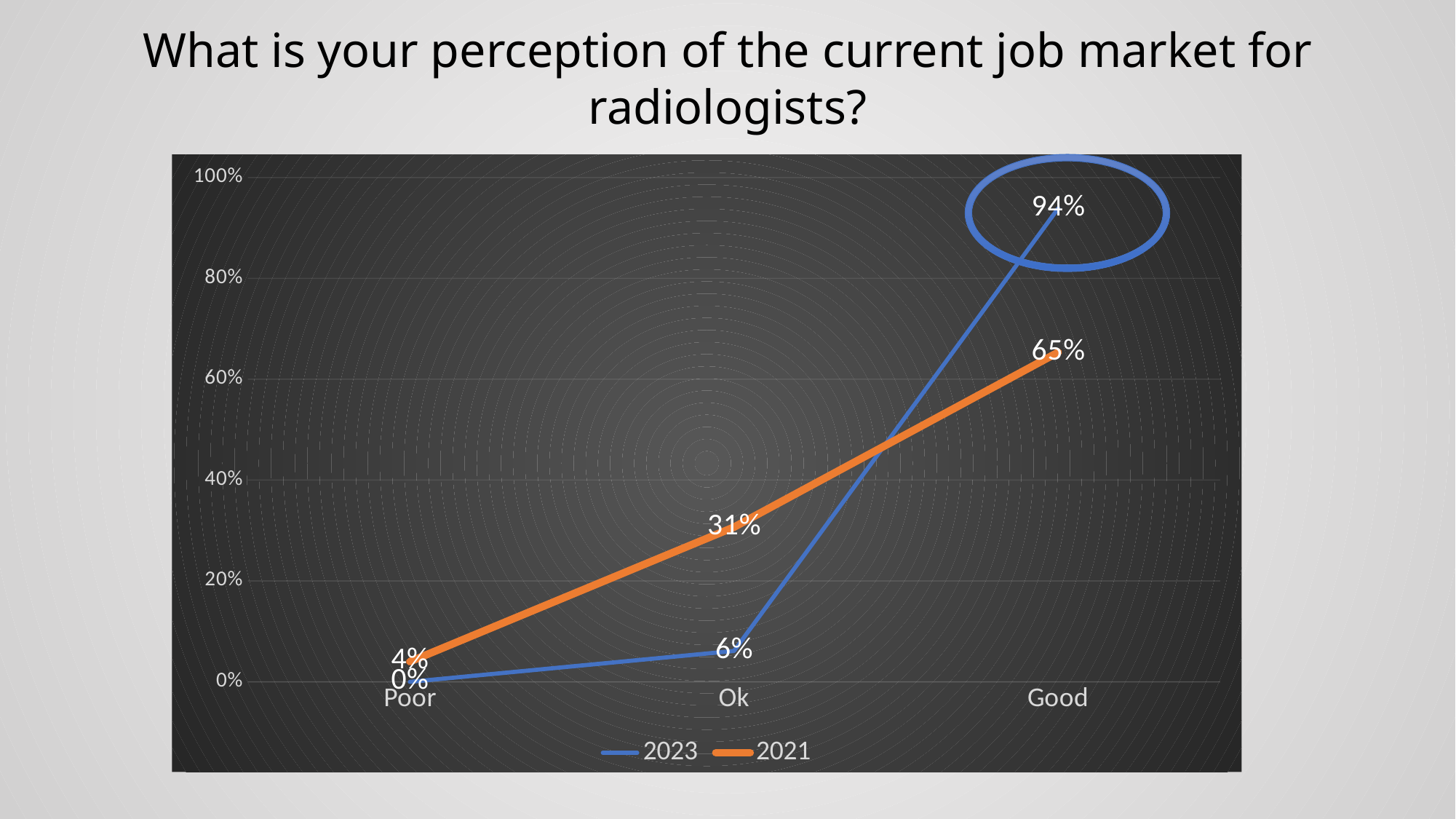
What is the value for Good in the 2023 series? 94% Which category has the highest value in the 2023 series? Good Which category has the lowest value in the 2021 series? Poor What kind of chart is shown on the slide? line chart What is the value for Ok in the 2021 series? 31% What is the difference between the 2023 and 2021 values for Good? 29% How many series does the legend list? 2 Which series has the larger value for Ok, 2023 or 2021? 2021 What is the value for Ok in the 2023 series? 6% How many categories are shown on the x axis? 3 What is the value for Good in the 2021 series? 65% Do the values in the 2021 series rise or fall from Poor to Good? rise